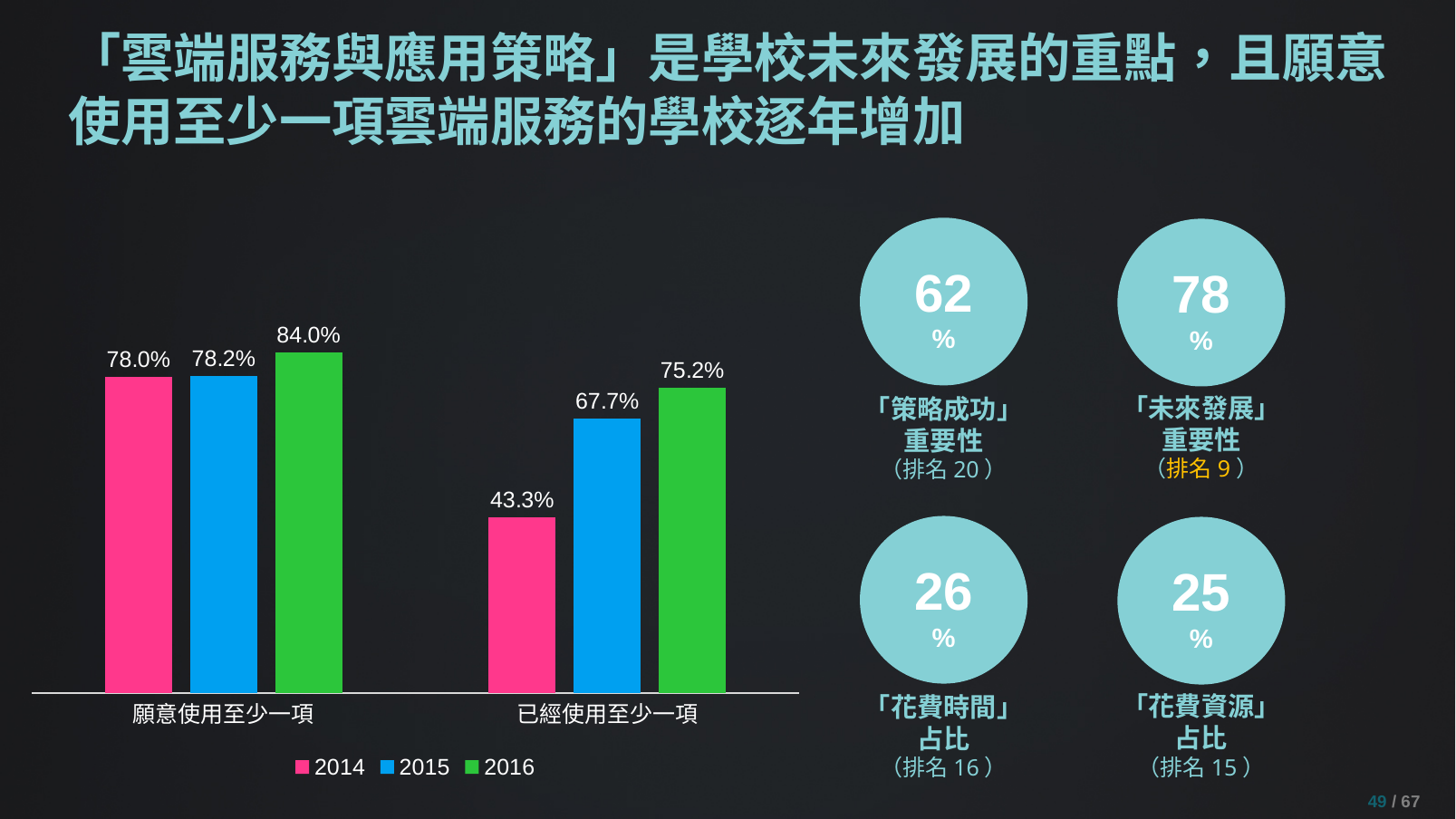
Which year has the lowest value for 已經使用至少一項? 2014 What is the 2014 value for 願意使用至少一項? 78.0% What is the 2015 value for 已經使用至少一項? 67.7% How many series does the legend list? 3 What kind of chart is shown on the slide? Bar chart What is the 2016 value for 願意使用至少一項? 84.0% What is the difference between the 2016 and 2015 values for 願意使用至少一項? 5.8% What is the 2014 value for 已經使用至少一項? 43.3% Which year has the highest value for 已經使用至少一項? 2016 Which is larger: the 2016 value for 願意使用至少一項 or the 2016 value for 已經使用至少一項? 願意使用至少一項 Do the values for 已經使用至少一項 rise or fall from 2014 to 2016? Rise What is the difference between the 2016 and 2014 values for 已經使用至少一項? 31.9%